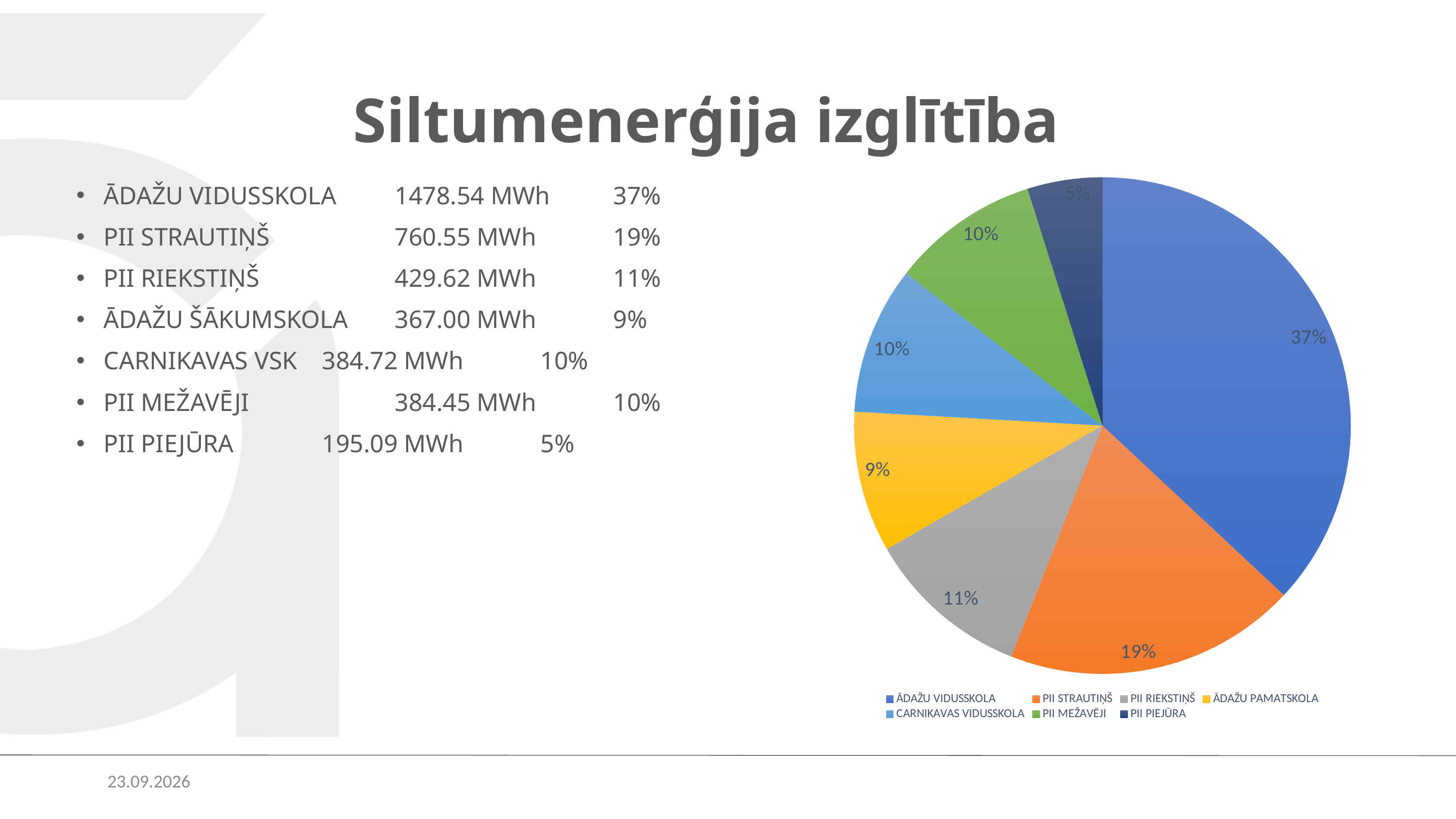
What share of the pie does ĀDAŽU VIDUSSKOLA have? 37% Which category has the largest slice of the pie? ĀDAŽU VIDUSSKOLA How many slices does the pie chart have? 7 What share of the pie does ĀDAŽU PAMATSKOLA have? 9% What kind of chart is shown on the slide? pie chart What share of the pie does PII STRAUTIŅŠ have? 19% Which slice is larger, PII RIEKSTIŅŠ or ĀDAŽU PAMATSKOLA? PII RIEKSTIŅŠ What is the difference in percentage points between the ĀDAŽU VIDUSSKOLA slice and the PII STRAUTIŅŠ slice? 18 Which category has the smallest slice of the pie? PII PIEJŪRA What colour is the PII STRAUTIŅŠ slice in the pie chart? orange